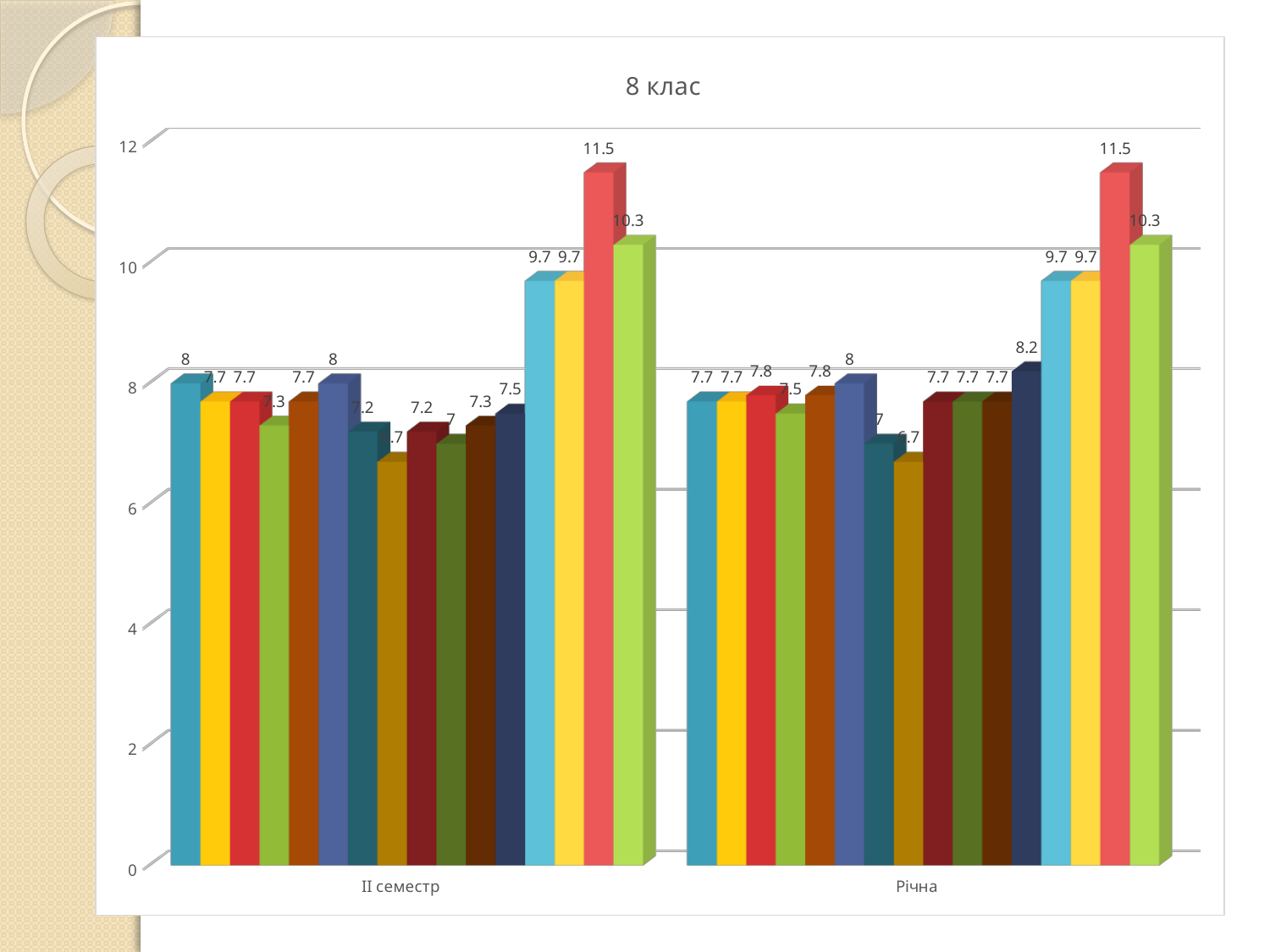
What are the two category labels on the x axis? II семестр, Річна Which is larger: the first (teal) bar in the II семестр group or the first (teal) bar in the Річна group? II семестр What is the difference between the highest value (11.5) and the lowest value (6.7) in the II семестр group? 4.8 Is the tallest bar in the Річна group greater or less than 10? greater How many categories are shown on the x axis of the chart? 2 What is the value of the tallest (salmon-coloured) bar in the Річна group? 11.5 What is the maximum value shown on the vertical axis? 12 What kind of chart is shown on the slide? bar chart What is the value of the last (light green) bar in the II семестр group? 10.3 What is the highest value labelled in the II семестр group? 11.5 What is the title of the chart? 8 клас What is the lowest value labelled in the Річна group? 6.7